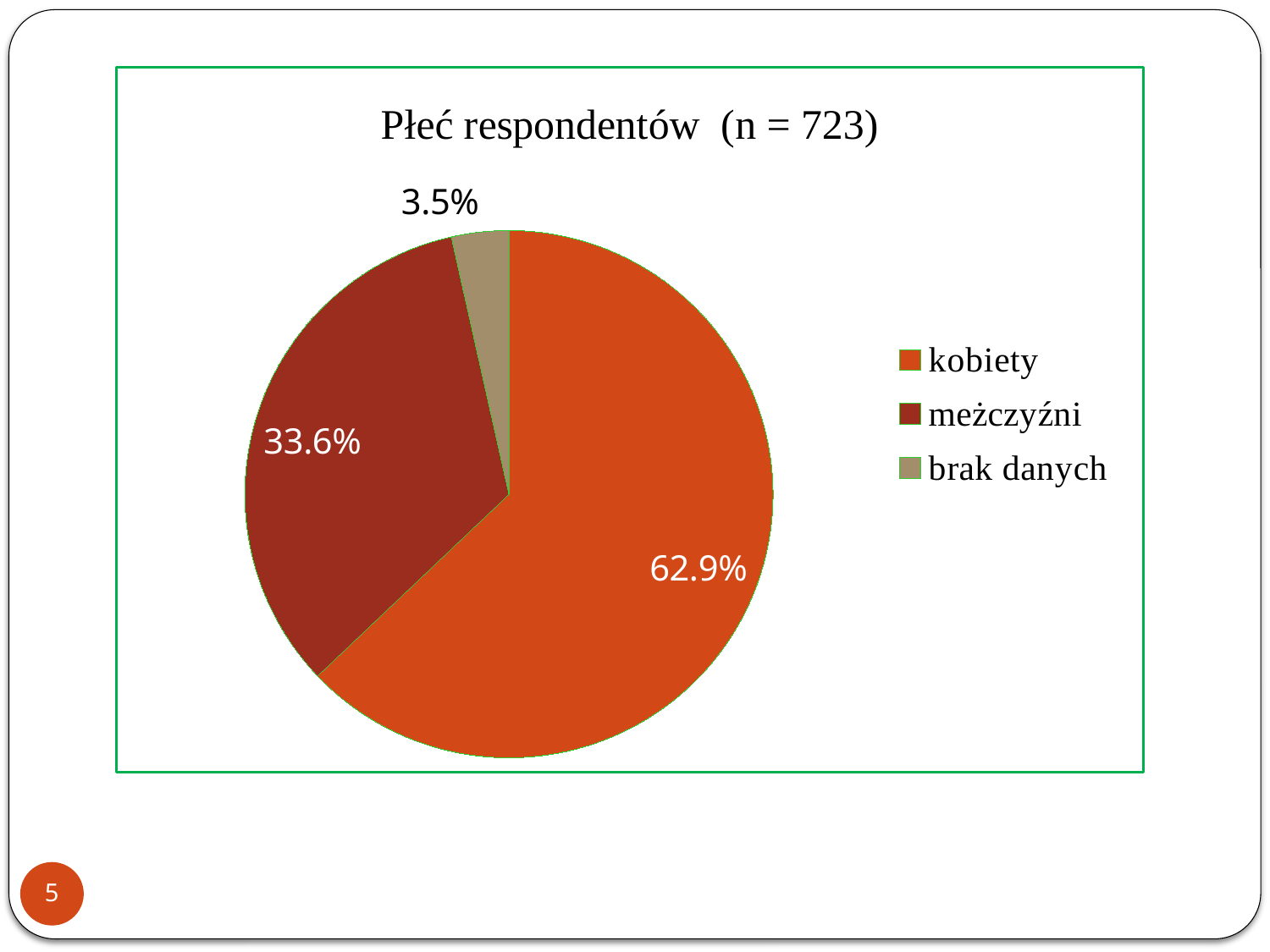
What kind of chart is shown on the slide? pie chart How many entries does the legend list? 3 What is the sample size (n) given in the chart title? 723 What is the difference in percentage points between the kobiety and mężczyźni slices? 29.3 What share of the pie does the kobiety slice represent? 62.9% Which category has the smallest slice of the pie? brak danych What share of the pie does the brak danych slice represent? 3.5% Which category has the largest slice of the pie? kobiety Which slice is larger, mężczyźni or brak danych? mężczyźni What is the title of the chart? Płeć respondentów (n = 723) How many categories are shown in the pie chart? 3 What share of the pie does the mężczyźni slice represent? 33.6%